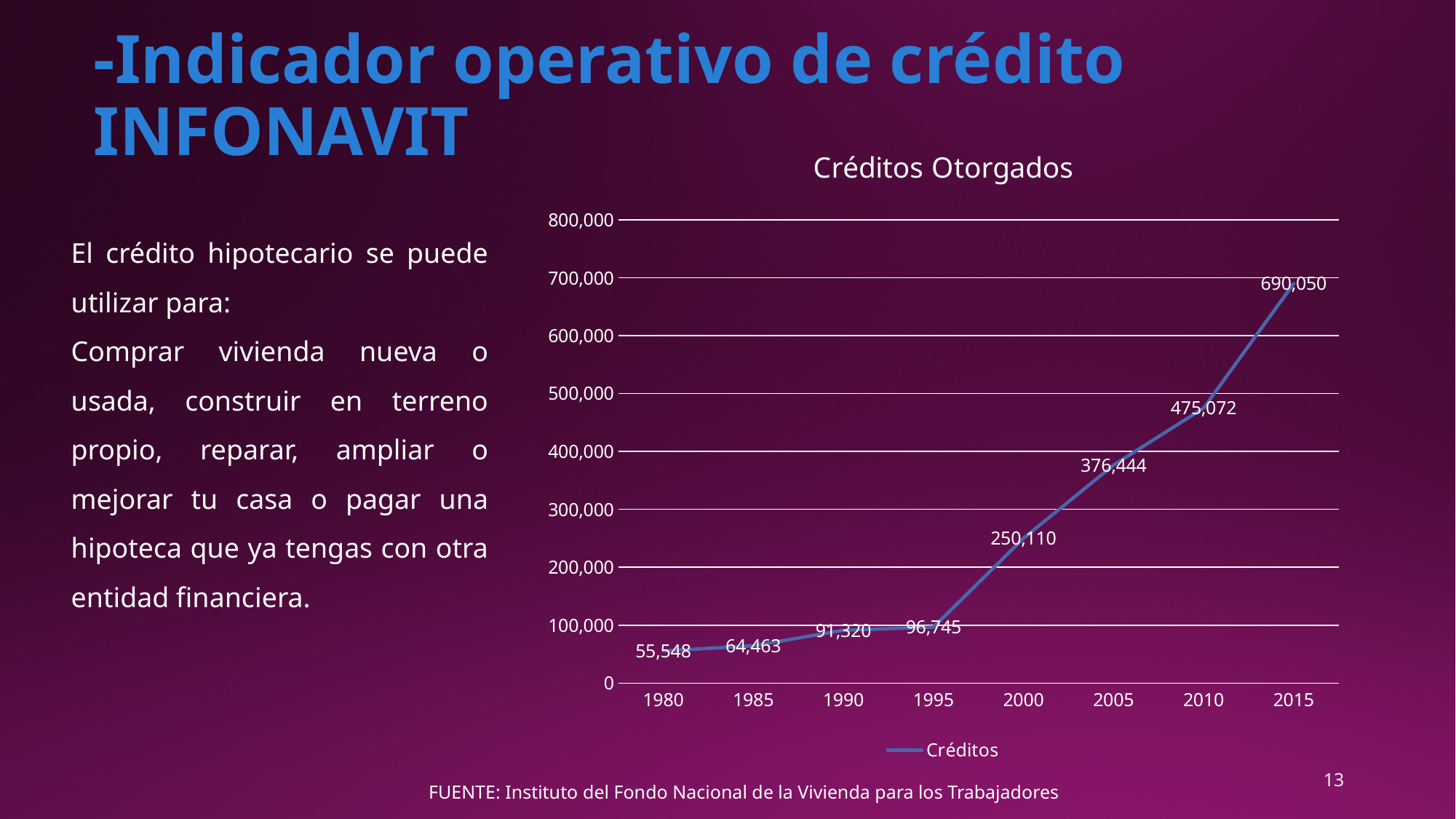
What is the difference between the values for 2010 and 2005 in the Créditos Otorgados chart? 98,628 Do the values in the Créditos Otorgados chart rise or fall from 1980 to 2015? rise What kind of chart is the Créditos Otorgados chart? line chart Which is larger in the Créditos Otorgados chart, the value for 1990 or the value for 1995? 1995 How many data points are plotted in the Créditos Otorgados chart? 8 What is the value for 2015 in the Créditos Otorgados chart? 690,050 Which year has the lowest value in the Créditos Otorgados chart? 1980 What is the value for 1980 in the Créditos Otorgados chart? 55,548 What is the value for 2000 in the Créditos Otorgados chart? 250,110 How many series does the legend of the Créditos Otorgados chart list? 1 Is the value for 2005 in the Créditos Otorgados chart greater or less than 400,000? less Which year has the highest value in the Créditos Otorgados chart? 2015